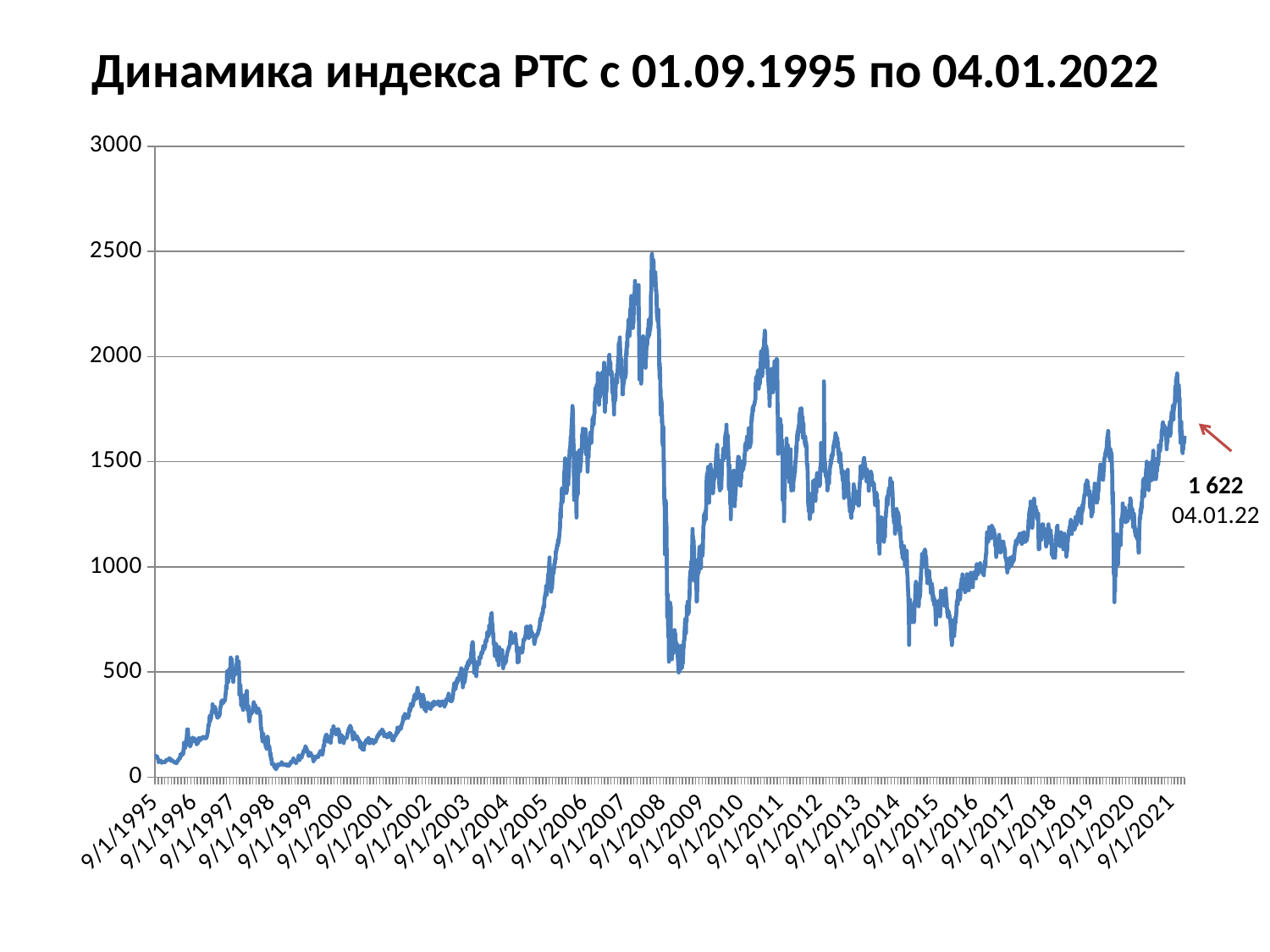
Is the highest value reached by the index on the chart greater or less than 2000? greater What value of the RTS index is labelled on the chart for 04.01.22? 1 622 How many date labels are shown on the horizontal axis? 27 What is the title of the chart? Динамика индекса РТС с 01.09.1995 по 04.01.2022 Does the index rise or fall between 9/1/2003 and 9/1/2007? rises What date is attached to the labelled value 1 622 on the chart? 04.01.22 Does the index rise or fall between 9/1/2011 and 9/1/2014? falls What kind of chart is shown on the slide? line chart Is the value of the index at 9/1/1995 greater or less than 500? less Is the value of the index at 9/1/2021 greater or less than 1500? greater